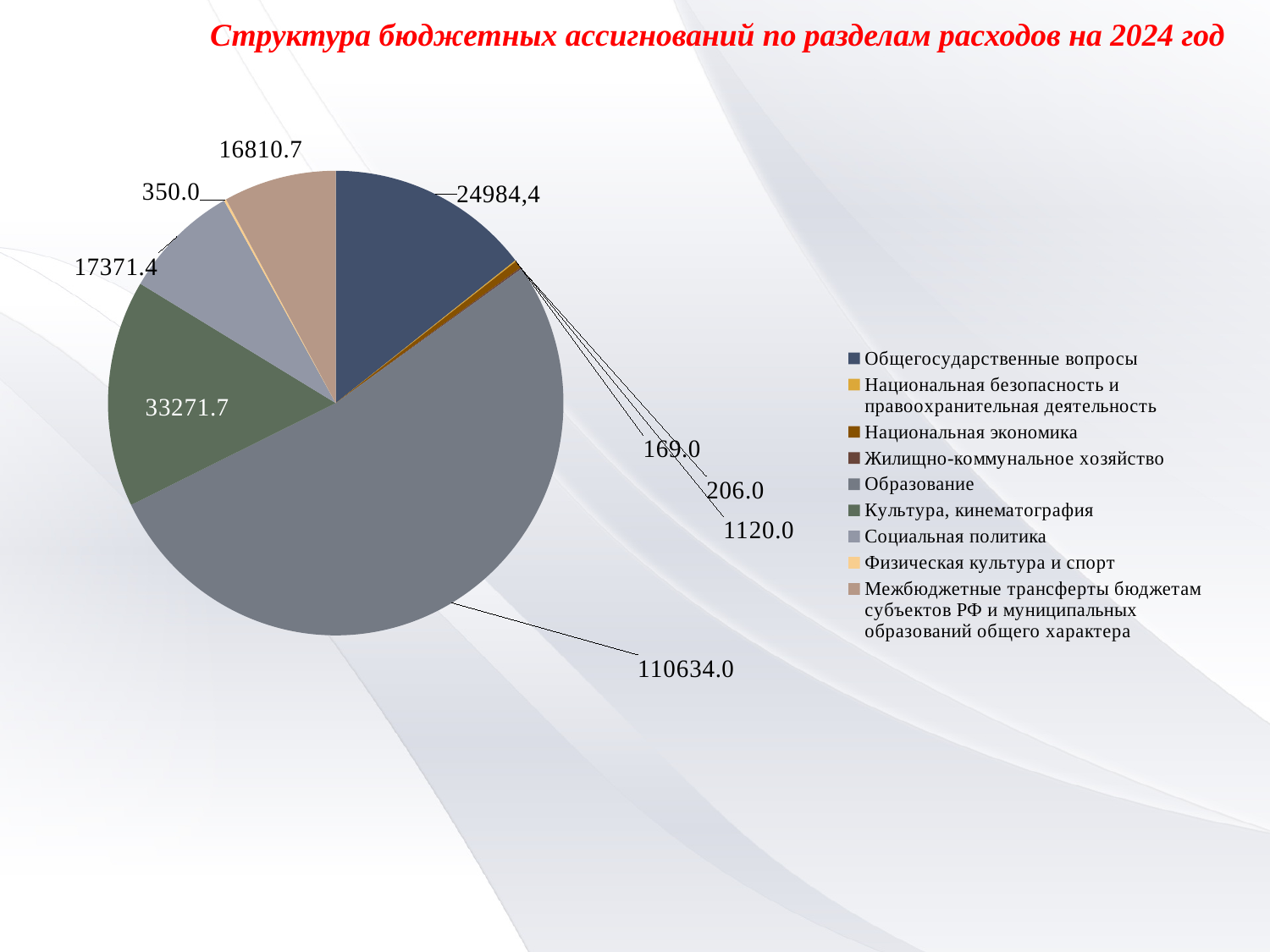
What is the difference between the values for Социальная политика and Межбюджетные трансферты? 560.7 How many categories does the legend of the pie chart list? 9 What kind of chart is shown on the slide? pie chart Which category has the largest slice of the pie chart? Образование What is the value for Культура, кинематография in the pie chart? 33271.7 What is the value for Образование in the pie chart? 110634.0 Which is larger: Культура, кинематография or Общегосударственные вопросы? Культура, кинематография What is the value for Общегосударственные вопросы in the pie chart? 24984,4 What is the value for Физическая культура и спорт in the pie chart? 350.0 What is the value for Социальная политика in the pie chart? 17371.4 What is the title of the chart on the slide? Структура бюджетных ассигнований по разделам расходов на 2024 год What is the value for Межбюджетные трансферты бюджетам субъектов РФ и муниципальных образований общего характера? 16810.7